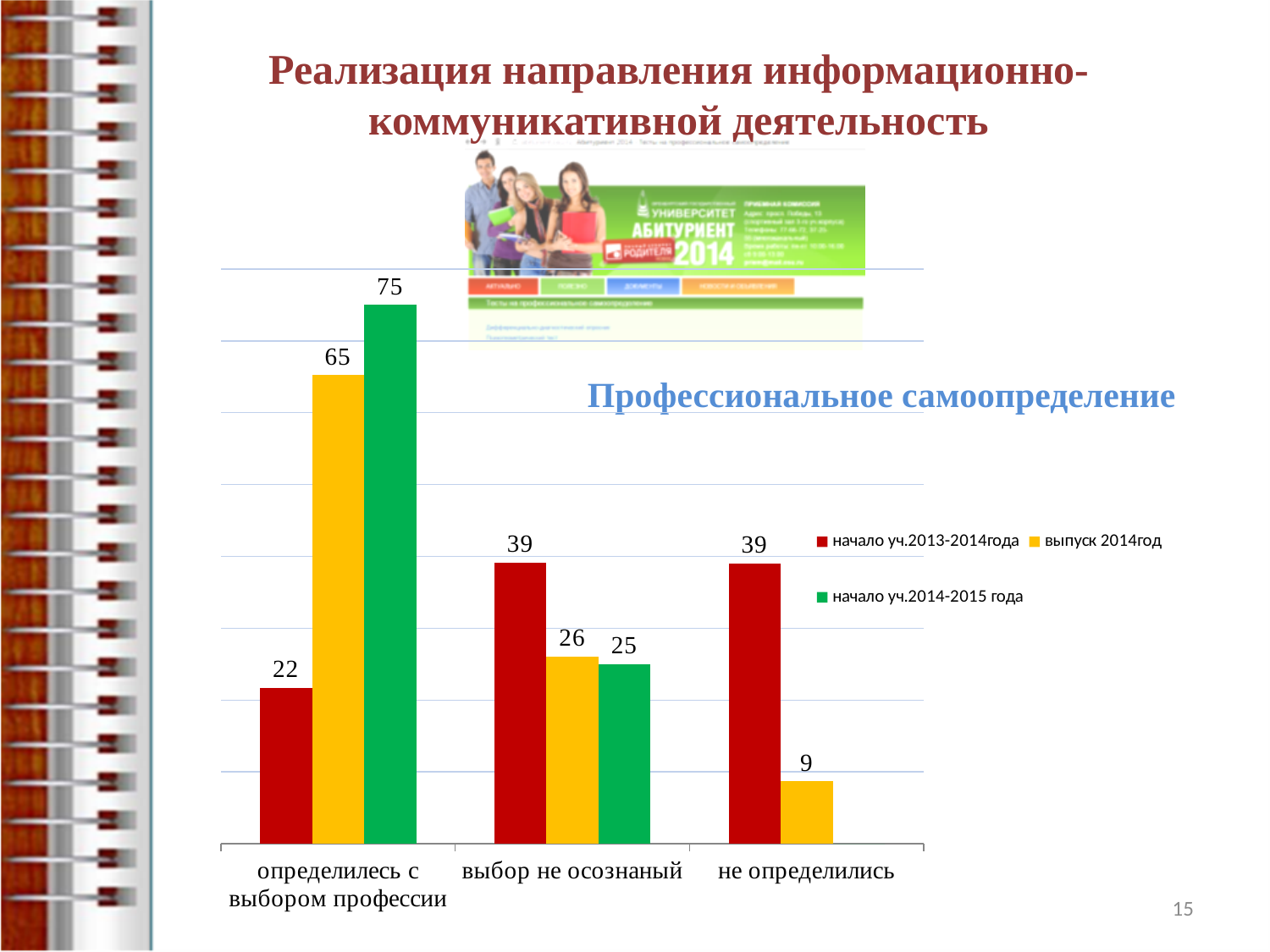
What is the value for "определилесь с выбором профессии" in the series "начало уч.2014-2015 года"? 75 How many series does the chart legend list? 3 What is the value for "выбор не осознаный" in the series "начало уч.2013-2014года"? 39 For "выбор не осознаный", which is larger: the "выпуск 2014год" value or the "начало уч.2014-2015 года" value? выпуск 2014год What is the difference between the "начало уч.2014-2015 года" value and the "начало уч.2013-2014года" value for "определилесь с выбором профессии"? 53 Which category has the lowest value in the series "начало уч.2013-2014года"? определилесь с выбором профессии How many categories are shown on the x axis of the chart? 3 Which category has the highest value in the series "начало уч.2014-2015 года"? определилесь с выбором профессии What is the title of the chart? Профессиональное самоопределение What is the value for "не определились" in the series "выпуск 2014год"? 9 What type of chart is shown on the slide? bar chart What is the value for "определилесь с выбором профессии" in the series "выпуск 2014год"? 65